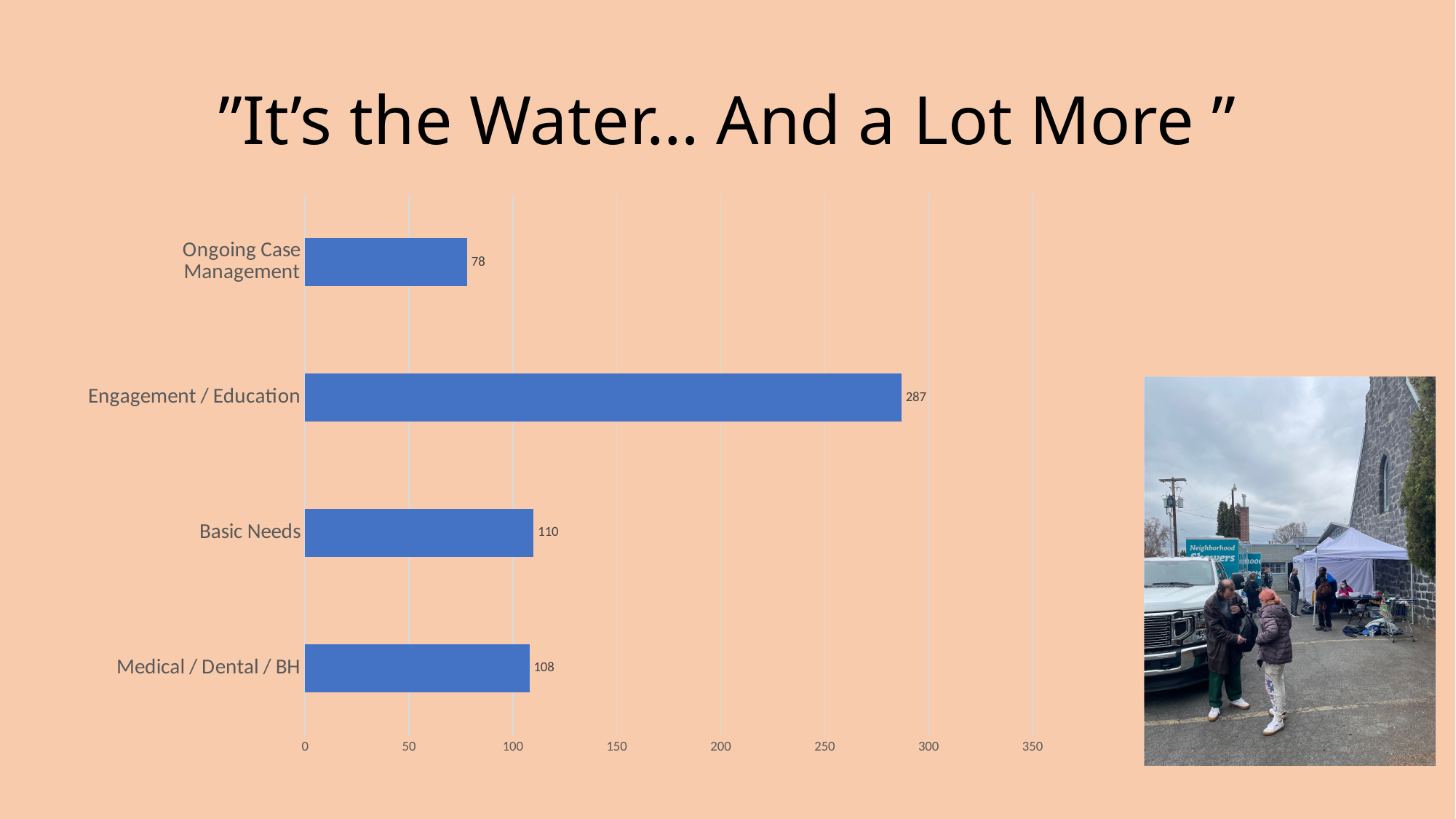
What is the value for Ongoing Case Management? 78 What is the value for Medical / Dental / BH? 108 What is the value for Engagement / Education? 287 What kind of chart is shown on the slide? Bar chart Which category has the highest value? Engagement / Education Which is larger, the value for Basic Needs or the value for Ongoing Case Management? Basic Needs Is the value for Engagement / Education greater or less than 250? greater What is the difference between the values for Basic Needs and Medical / Dental / BH? 2 How many categories are shown in the chart? 4 Which category has the lowest value? Ongoing Case Management What is the value for Basic Needs? 110 What is the difference between the values for Engagement / Education and Basic Needs? 177